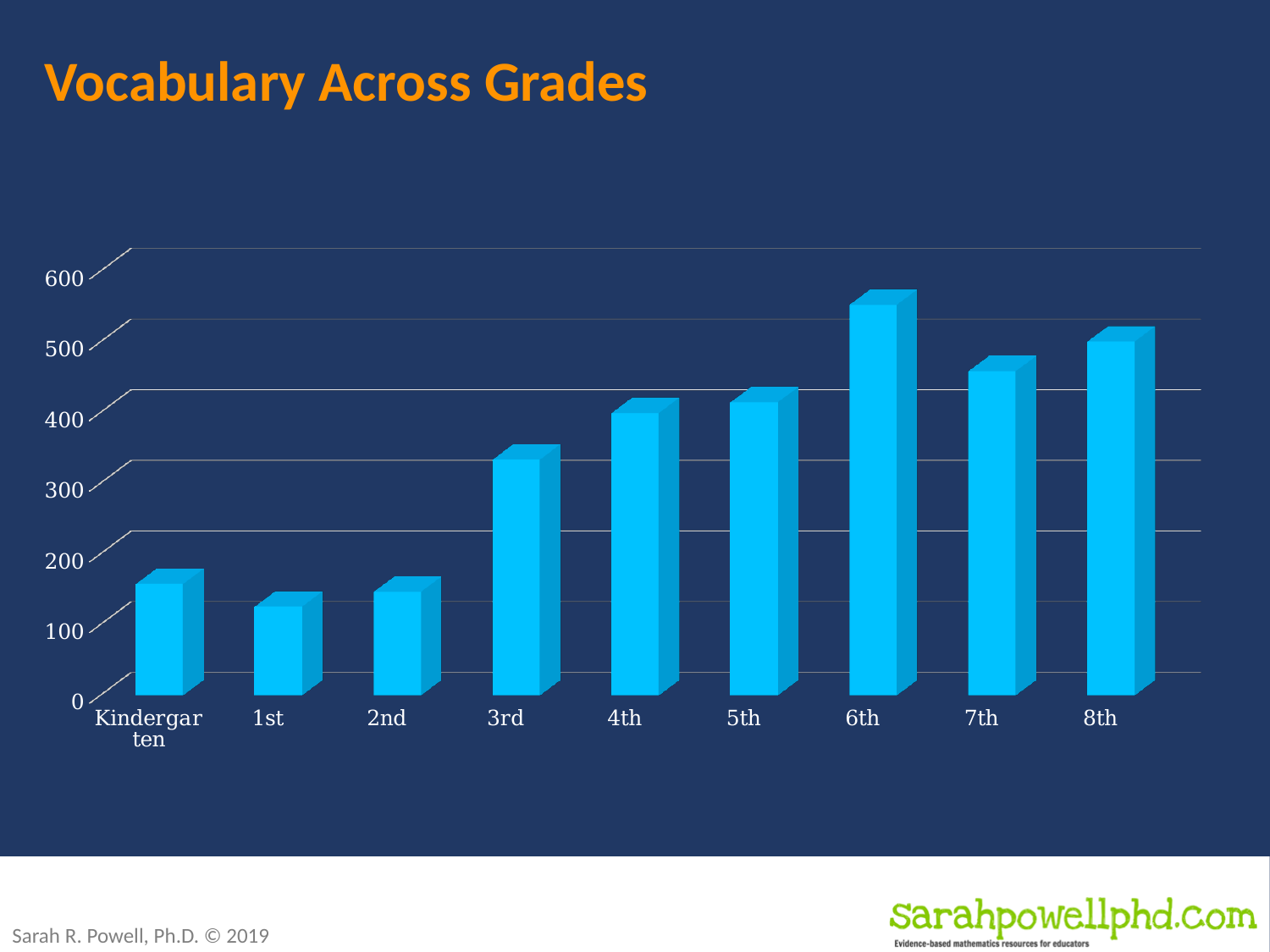
What is the title of the chart? Vocabulary Across Grades What kind of chart is shown on the slide? bar chart Which is larger, the value for 6th grade or the value for 8th grade? 6th Do the values generally rise or fall from Kindergarten to 8th grade? rise Which grade has the highest bar? 6th Is the value for Kindergarten greater or less than 200? less How many grade categories are plotted on the x axis? 9 Is the value for 1st grade greater or less than 100? greater Which grade has the lowest bar? 1st Is the value for 7th grade greater or less than 500? less